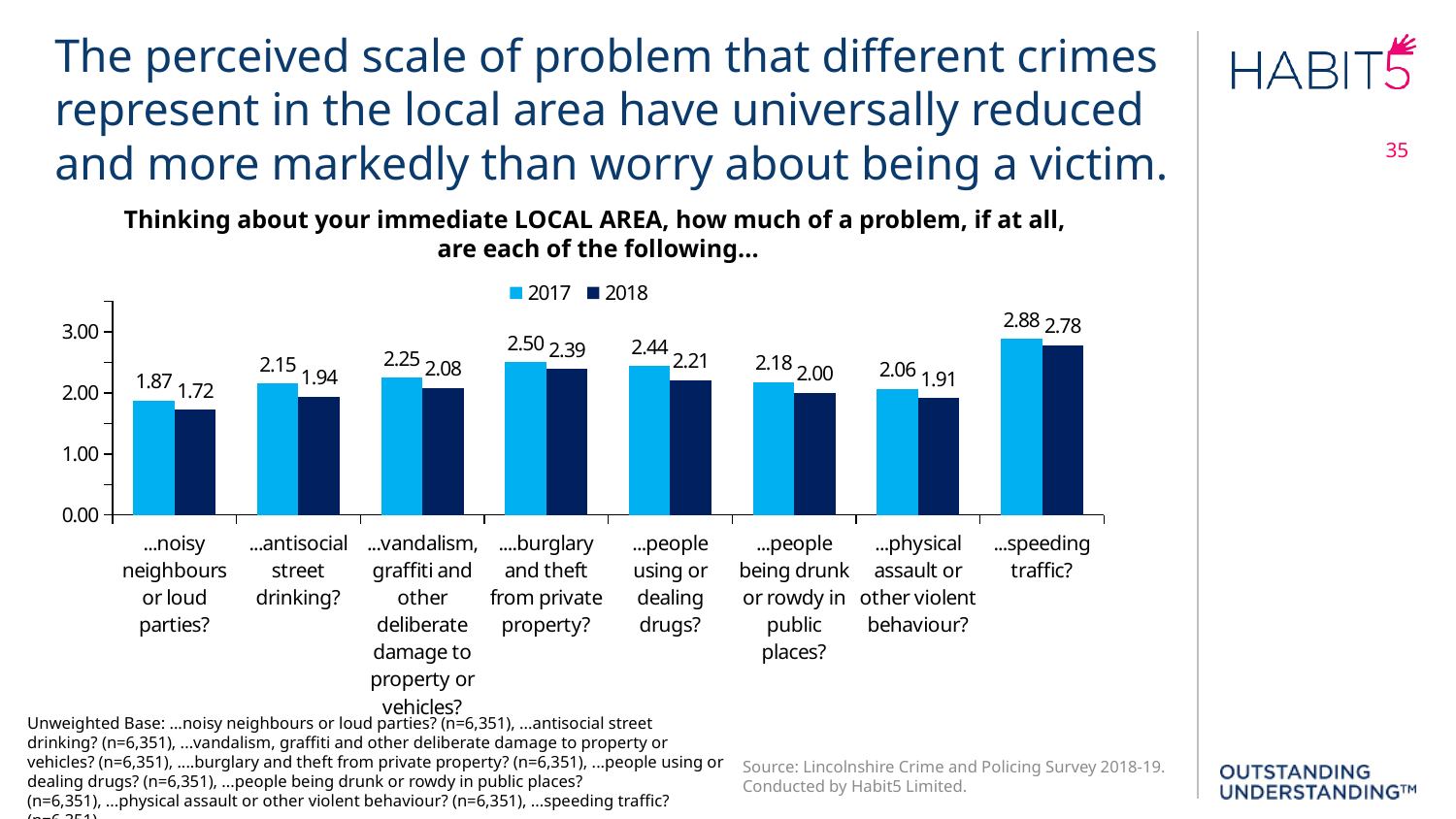
How many series does the legend list? 2 What is the 2017 value for "...speeding traffic?"? 2.88 Is the 2018 value for "...physical assault or other violent behaviour?" greater or less than 2.00? less Which is larger: the 2017 value for "...antisocial street drinking?" or the 2017 value for "...vandalism, graffiti and other deliberate damage to property or vehicles?"? ...vandalism, graffiti and other deliberate damage to property or vehicles? Which category has the lowest 2018 value? ...noisy neighbours or loud parties? Which series is shown in the darker blue colour? 2018 What kind of chart is shown on the slide? bar chart Which category has the highest 2017 value? ...speeding traffic? How many categories are shown on the x axis? 8 What is the 2018 value for "...noisy neighbours or loud parties?"? 1.72 What is the 2018 value for "...burglary and theft from private property?"? 2.39 What is the difference between the 2017 and 2018 values for "...people using or dealing drugs?"? 0.23